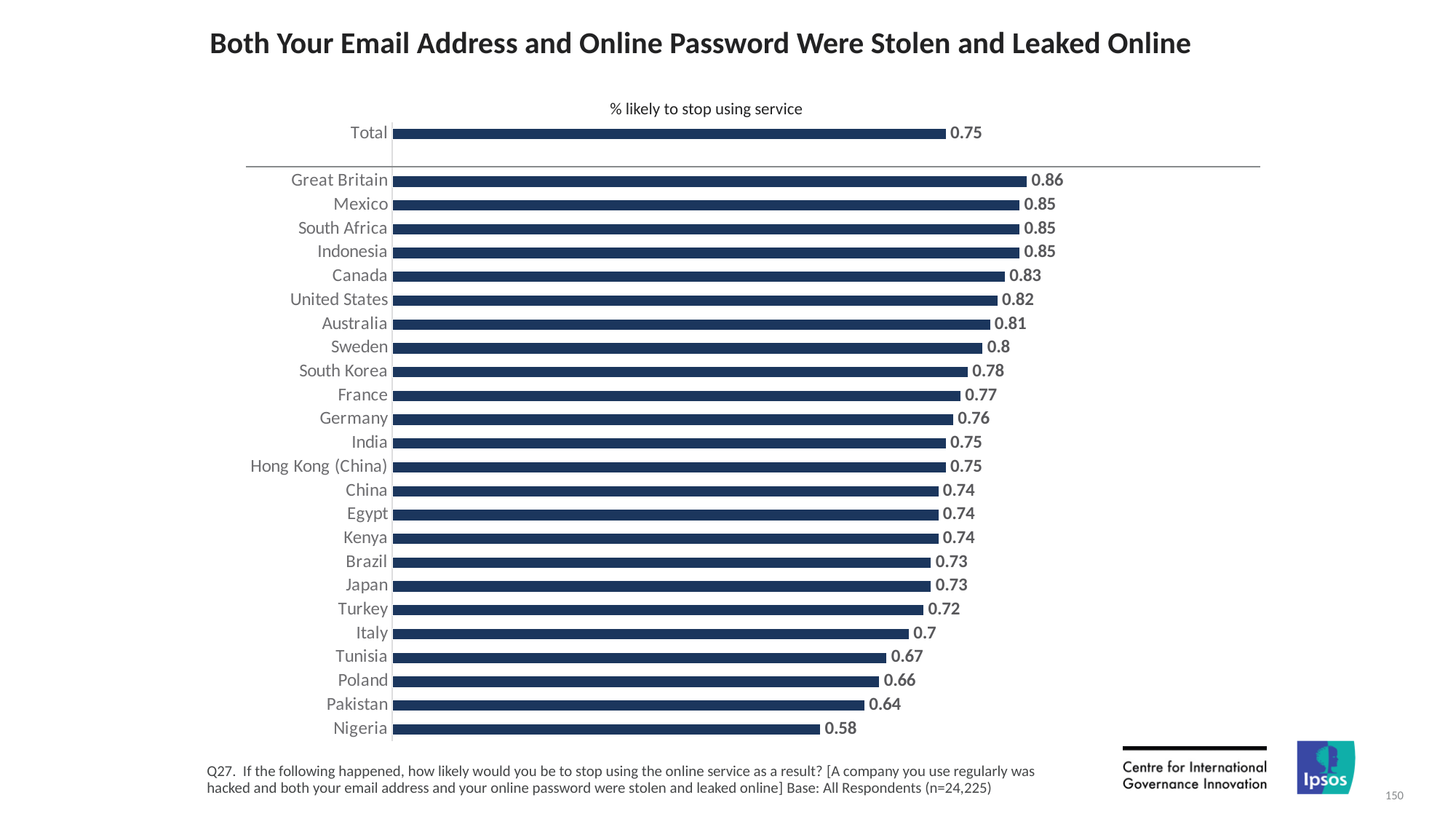
What is the subtitle shown above the bars in the chart? % likely to stop using service What is the value for Nigeria? 0.58 Which country has the highest value? Great Britain How many countries are shown in the chart, excluding the Total bar? 24 What is the value for Canada? 0.83 Which country has the lowest value? Nigeria What is the value for the Total bar? 0.75 Which has a larger value, Sweden or Poland? Sweden What is the difference between the values for Great Britain and Nigeria? 0.28 What is the value for Great Britain? 0.86 What is the difference between the values for Canada and Italy? 0.13 What kind of chart is shown on the slide? Bar chart